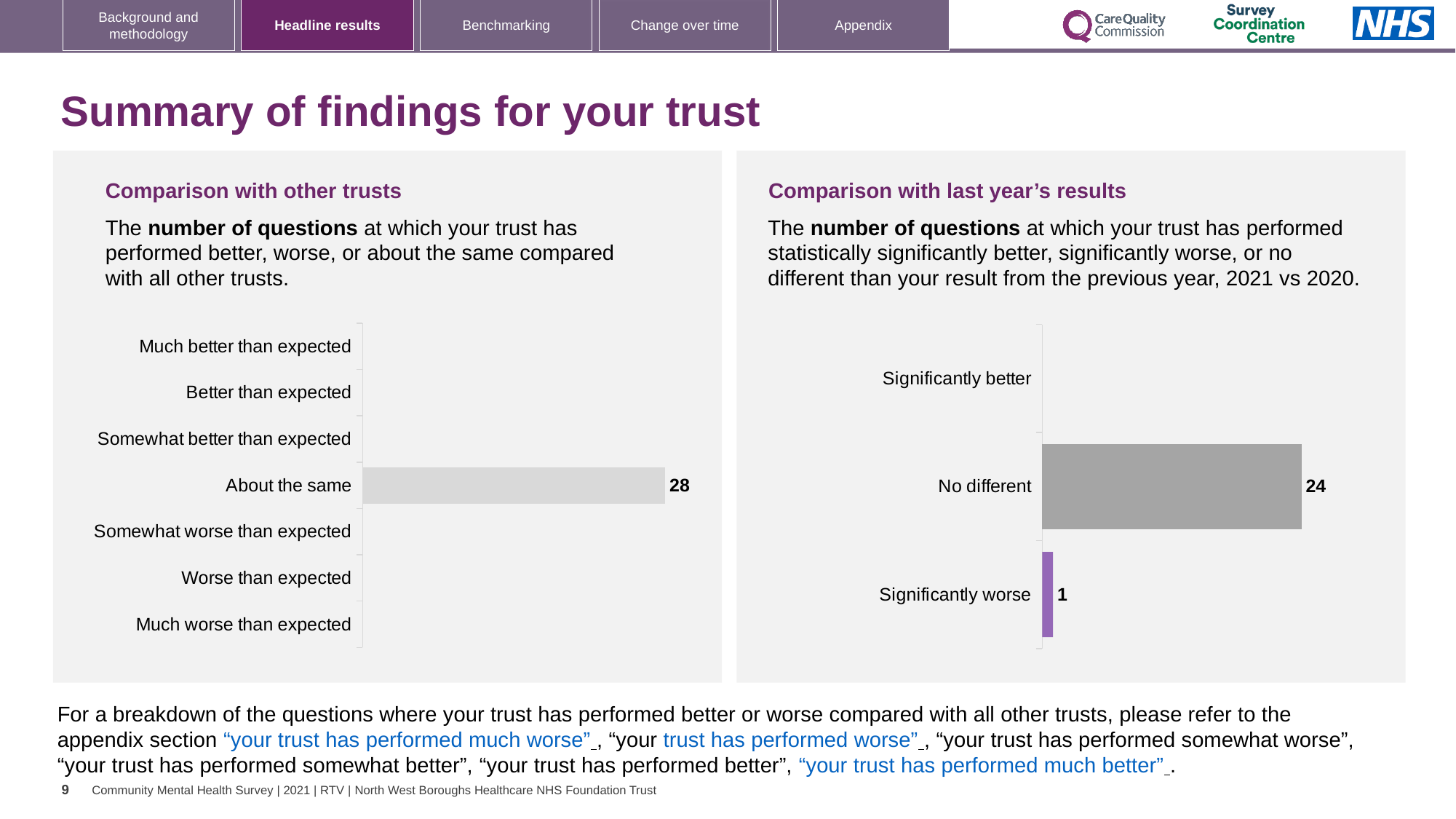
In the 'Comparison with last year's results' chart, what is the value for 'Significantly worse'? 1 In the 'Comparison with last year's results' chart, which is larger: 'No different' or 'Significantly worse'? No different What kind of chart is the 'Comparison with other trusts' chart? Bar chart In the 'Comparison with last year's results' chart, which category has no bar shown? Significantly better In the 'Comparison with last year's results' chart, which category has the highest value? No different In the 'Comparison with other trusts' chart, which category has the highest value? About the same How many categories are listed on the 'Comparison with other trusts' chart? 7 What is the title of the chart on the right side of the slide? Comparison with last year's results In the 'Comparison with other trusts' chart, what is the value for 'About the same'? 28 In the 'Comparison with last year's results' chart, what is the value for 'No different'? 24 How many categories are listed on the 'Comparison with last year's results' chart? 3 In the 'Comparison with last year's results' chart, what is the difference between 'No different' and 'Significantly worse'? 23